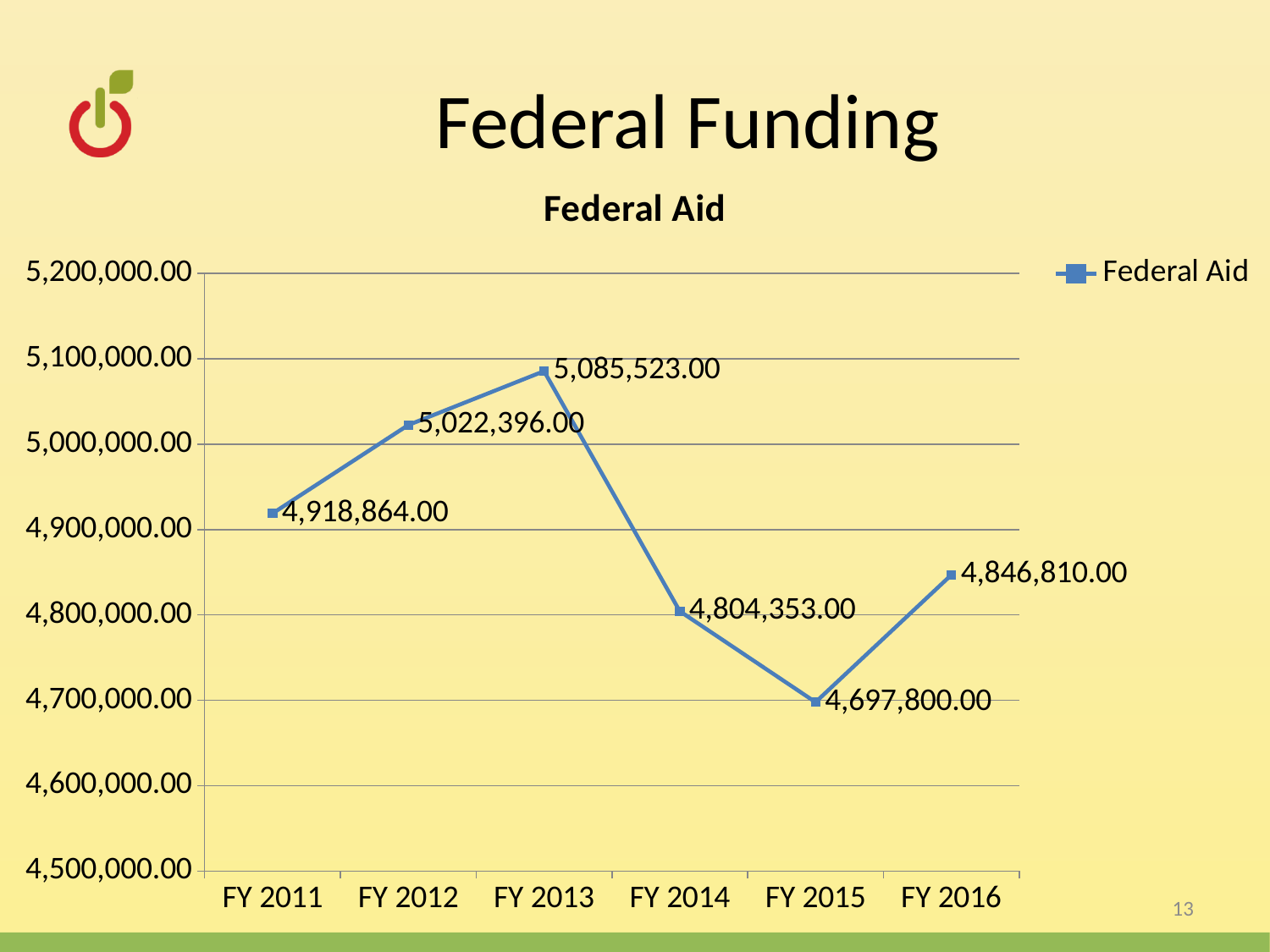
How many series does the legend list? 1 What is the difference between the Federal Aid values for FY 2013 and FY 2015? 387,723.00 What is the Federal Aid value for FY 2015? 4,697,800.00 Which fiscal year has the lowest Federal Aid value? FY 2015 What is the difference between the Federal Aid values for FY 2012 and FY 2011? 103,532.00 How many fiscal years are plotted on the chart? 6 Which fiscal year has the highest Federal Aid value? FY 2013 What is the Federal Aid value for FY 2011? 4,918,864.00 Does the Federal Aid value rise or fall from FY 2013 to FY 2015? fall What is the Federal Aid value for FY 2013? 5,085,523.00 What kind of chart is shown on the slide? line chart Which is larger, the Federal Aid value for FY 2014 or for FY 2016? FY 2016